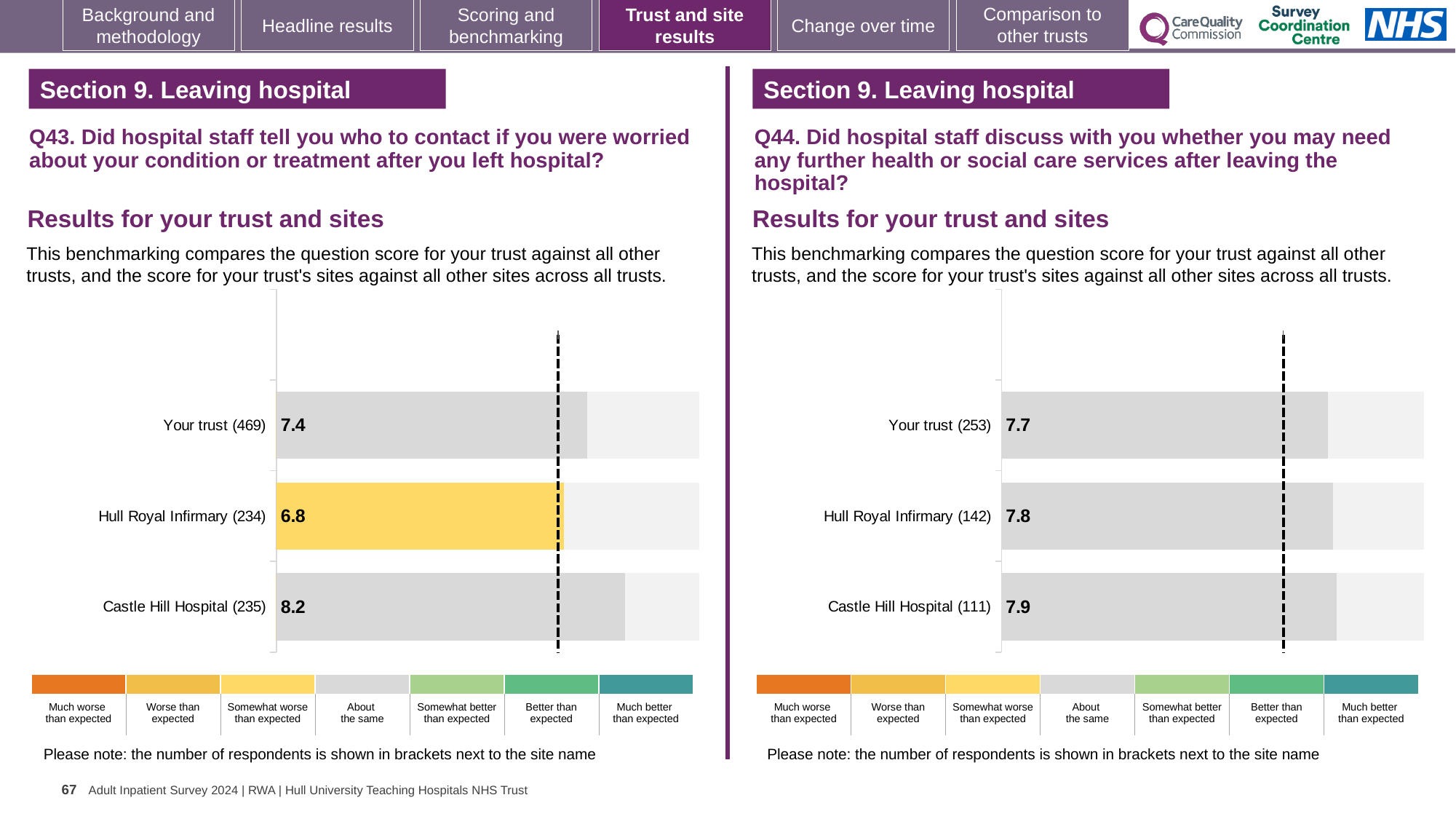
On the Q43 chart (left), which site or trust has the lowest score? Hull Royal Infirmary On the Q43 chart (left), how many respondents are shown for Your trust? 469 On the Q44 chart (right), which is larger, the score for Hull Royal Infirmary or Your trust? Hull Royal Infirmary On the Q44 chart (right), what is the score for Your trust? 7.7 On the Q43 chart (left), what is the score for Hull Royal Infirmary? 6.8 What kind of chart is used on the Q43 chart (left)? Bar chart On the Q43 chart (left), what is the difference between the scores for Castle Hill Hospital and Hull Royal Infirmary? 1.4 On the Q43 chart (left), which site or trust has the highest score? Castle Hill Hospital On the Q44 chart (right), how many bars are plotted? 3 On the Q44 chart (right), what is the score for Castle Hill Hospital? 7.9 On the Q43 chart (left), which benchmark category does the colour of the Hull Royal Infirmary bar indicate? Somewhat worse than expected On the Q43 chart (left), what is the score for Your trust? 7.4